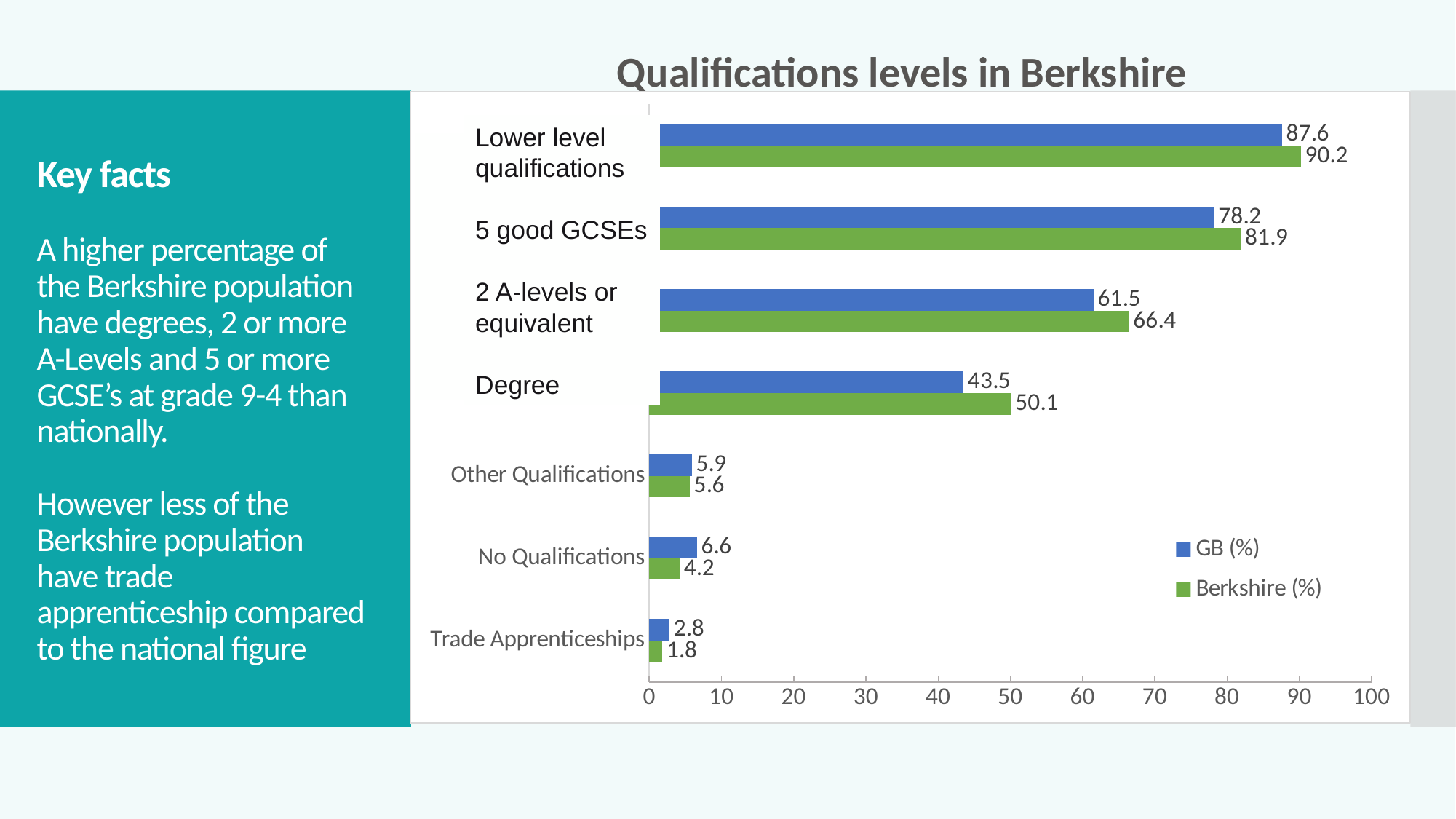
What is the difference between the Berkshire (%) and GB (%) values for 2 A-levels or equivalent? 4.9 What is the Berkshire (%) value for Trade Apprenticeships? 1.8 For No Qualifications, which is larger: the GB (%) value or the Berkshire (%) value? GB (%) What is the difference between the Berkshire (%) and GB (%) values for Degree? 6.6 Which category has the lowest GB (%) value? Trade Apprenticeships How many qualification categories are shown on the chart? 7 How many series does the legend list? 2 What is the title of the chart? Qualifications levels in Berkshire What is the GB (%) value for 5 good GCSEs? 78.2 What is the Berkshire (%) value for Degree? 50.1 Which category has the highest Berkshire (%) value? Lower level qualifications What kind of chart is shown on the slide? Bar chart